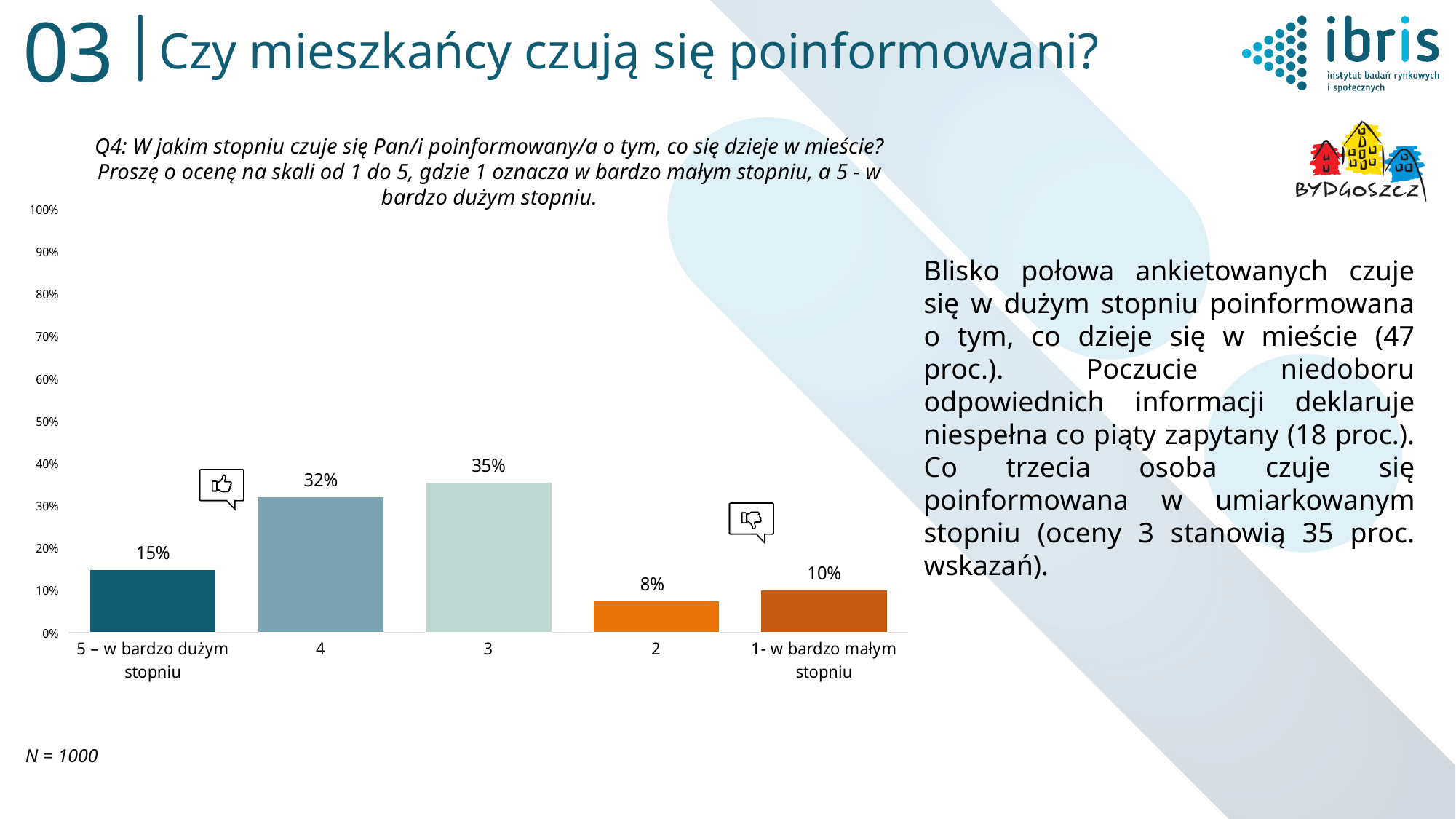
What is the value shown for rating 3? 35% What percentage of respondents chose rating 2? 8% Which is larger: the value for "5 – w bardzo dużym stopniu" or for "1- w bardzo małym stopniu"? 5 – w bardzo dużym stopniu How many categories are shown on the x axis of the chart? 5 What is the difference between the values for rating 3 and rating 4? 3% What is the value shown for rating 4? 32% Which rating category has the lowest value? 2 What percentage of respondents chose "5 – w bardzo dużym stopniu"? 15% What is the value for "1- w bardzo małym stopniu"? 10% What type of chart is shown on the slide? bar chart Which rating category has the highest value? 3 What is the sample size (N) stated below the chart? N = 1000